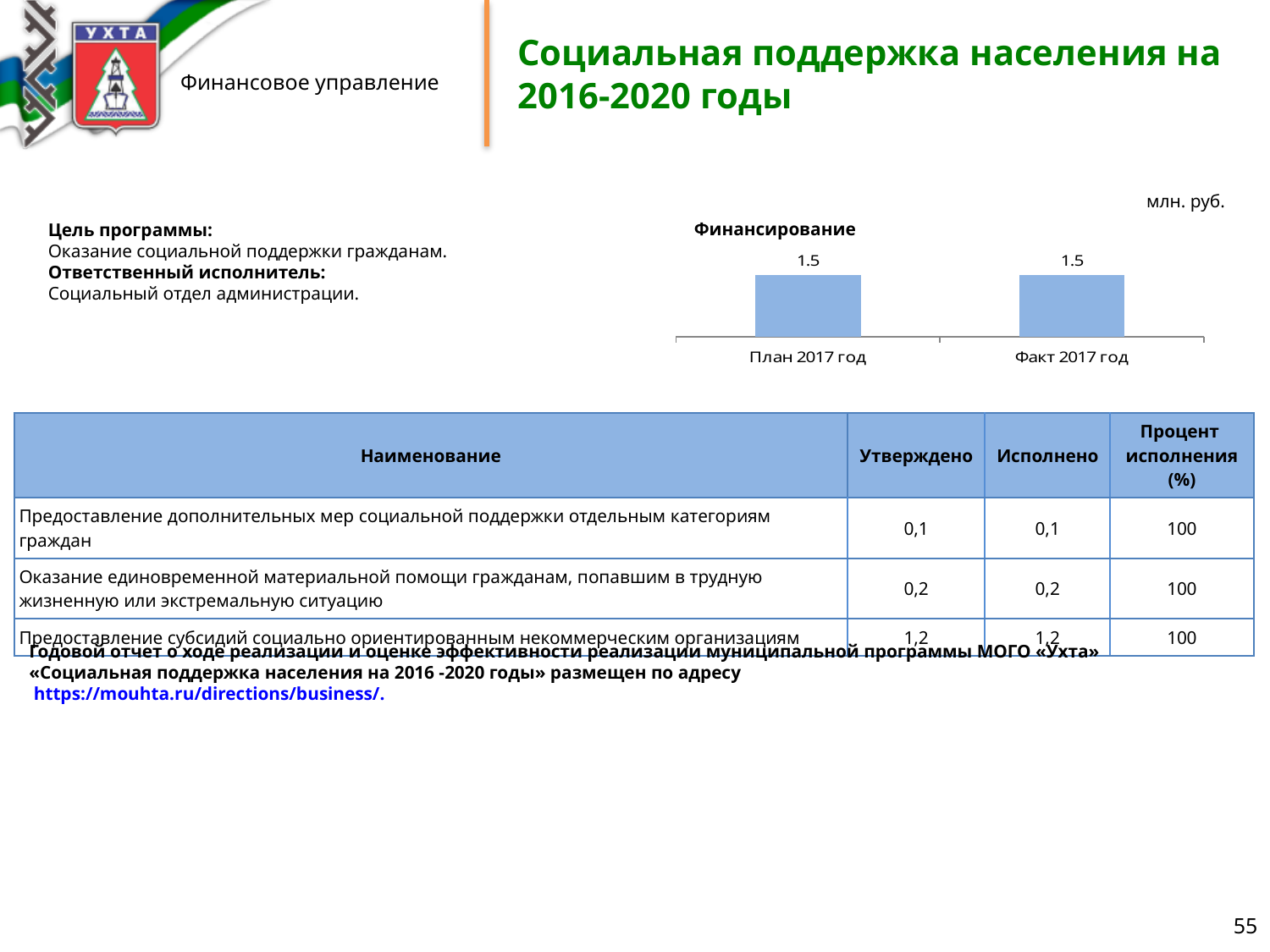
What is the title of the chart on the slide? Финансирование How many categories are shown in the Финансирование chart? 2 Do the values in the Финансирование chart rise, fall, or stay the same from План 2017 год to Факт 2017 год? stay the same What unit is indicated for the values in the Финансирование chart? млн. руб. What is the value for Факт 2017 год in the Финансирование chart? 1.5 What is the value for План 2017 год in the Финансирование chart? 1.5 What is the difference between the План 2017 год and Факт 2017 год values in the Финансирование chart? 0 What is the total of the two bars in the Финансирование chart? 3.0 What kind of chart is the Финансирование chart? bar chart